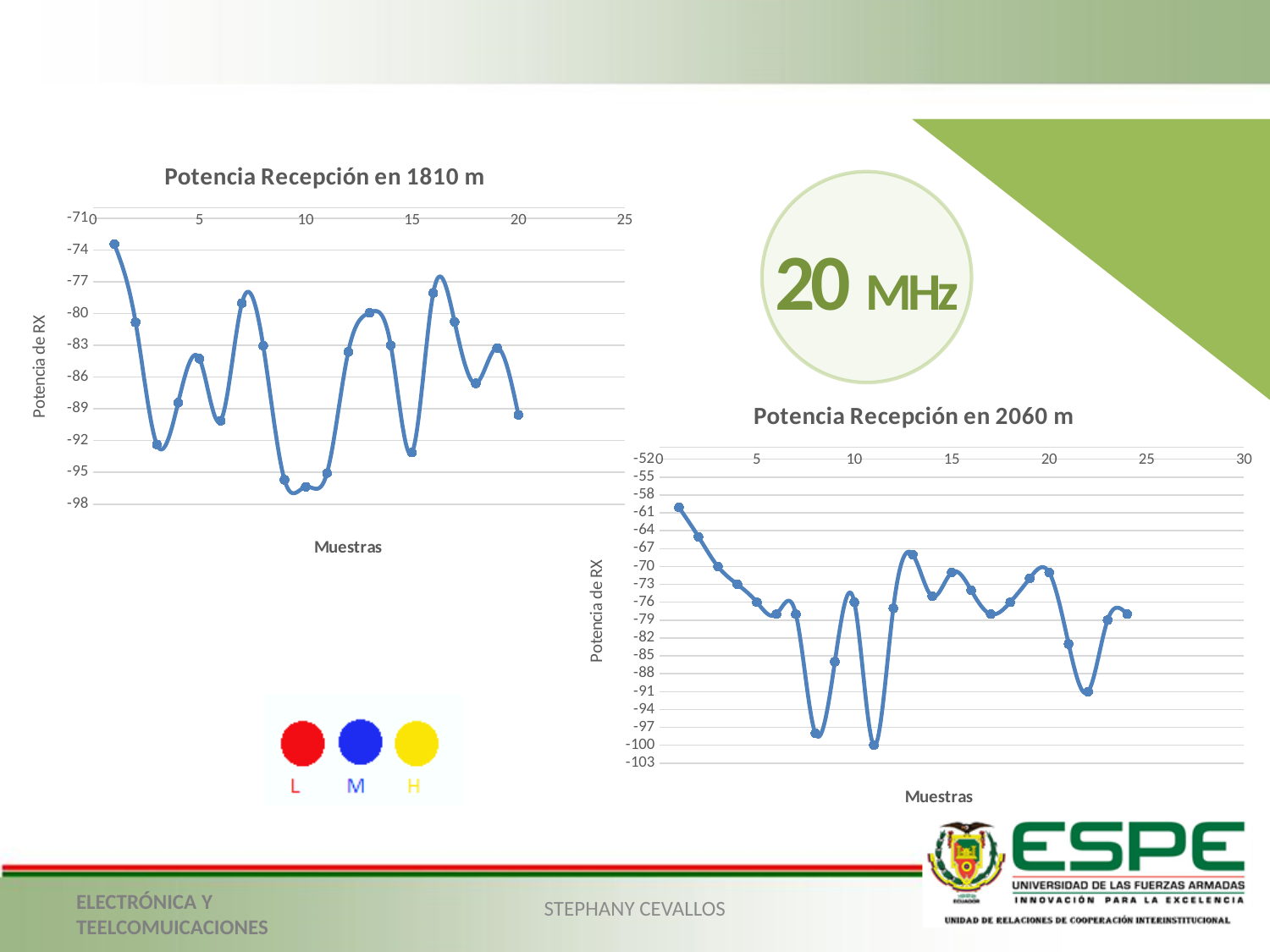
In the chart 'Potencia Recepción en 1810 m', is the value at sample 9 greater or less than -92? less In the chart 'Potencia Recepción en 2060 m', at which sample number is the received power highest? 1 What is the label of the x axis on the chart 'Potencia Recepción en 1810 m'? Muestras In the chart 'Potencia Recepción en 1810 m', which is higher, the value at sample 1 or the value at sample 20? sample 1 In the chart 'Potencia Recepción en 1810 m', is the value at sample 1 greater or less than -77? greater What type of chart is 'Potencia Recepción en 1810 m'? line chart What type of chart is 'Potencia Recepción en 2060 m'? line chart In the chart 'Potencia Recepción en 2060 m', at which sample number is the received power lowest? 11 In the chart 'Potencia Recepción en 2060 m', is the value at sample 13 greater or less than -76? greater In the chart 'Potencia Recepción en 2060 m', do the values rise or fall from sample 1 to sample 7? fall